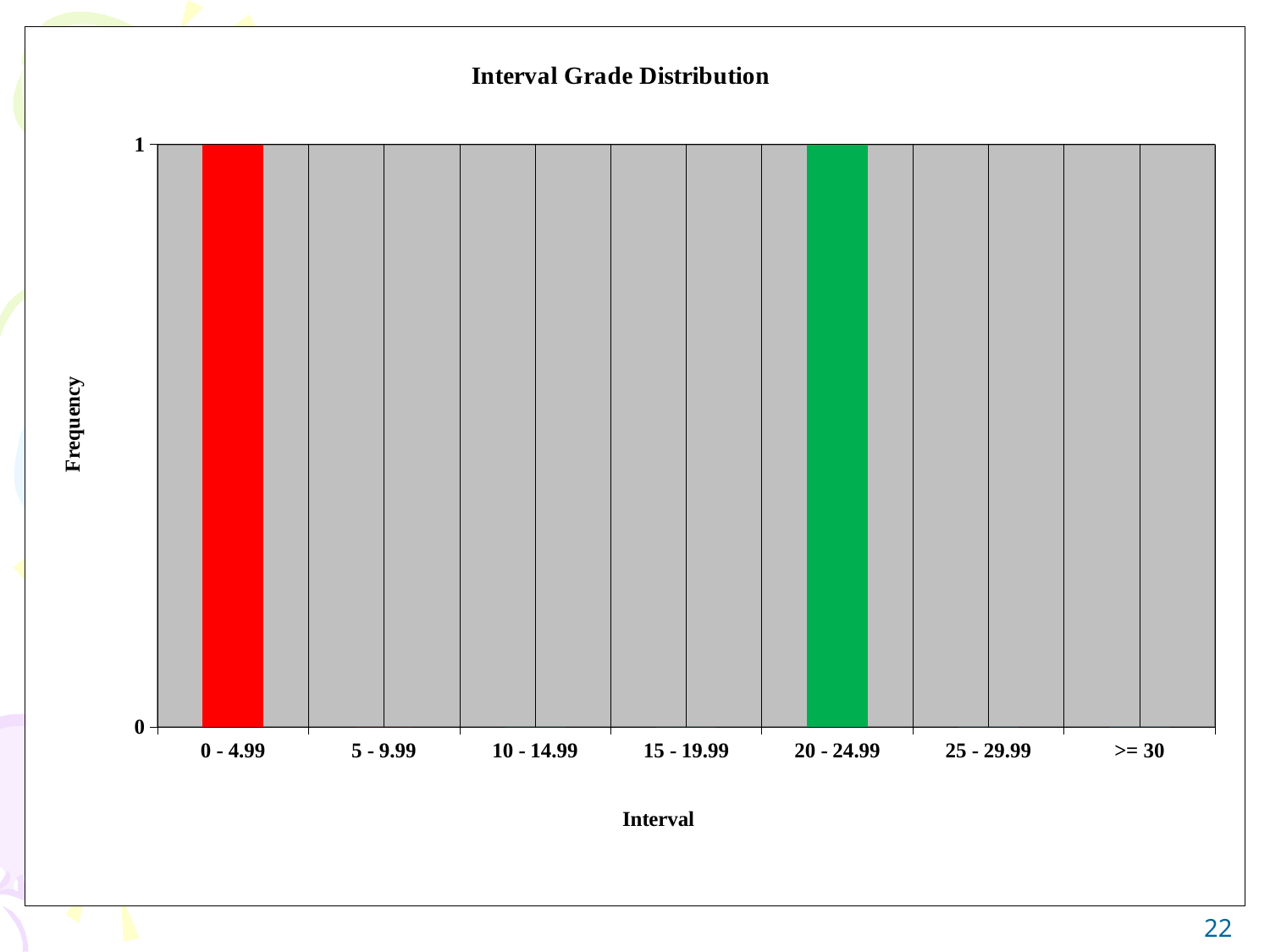
What is the frequency for the interval >= 30? 0 What is the frequency for the interval 20 - 24.99? 1 What is the frequency for the interval 0 - 4.99? 1 What is the title of the chart? Interval Grade Distribution What is the difference between the frequency for 20 - 24.99 and the frequency for 15 - 19.99? 1 What is the frequency for the interval 5 - 9.99? 0 Which has the higher frequency, the interval 0 - 4.99 or the interval 5 - 9.99? 0 - 4.99 How many interval categories are shown on the x axis? 7 What kind of chart is shown on the slide? bar chart How many intervals have a frequency greater than 0? 2 What colour is the bar for the interval 0 - 4.99? red